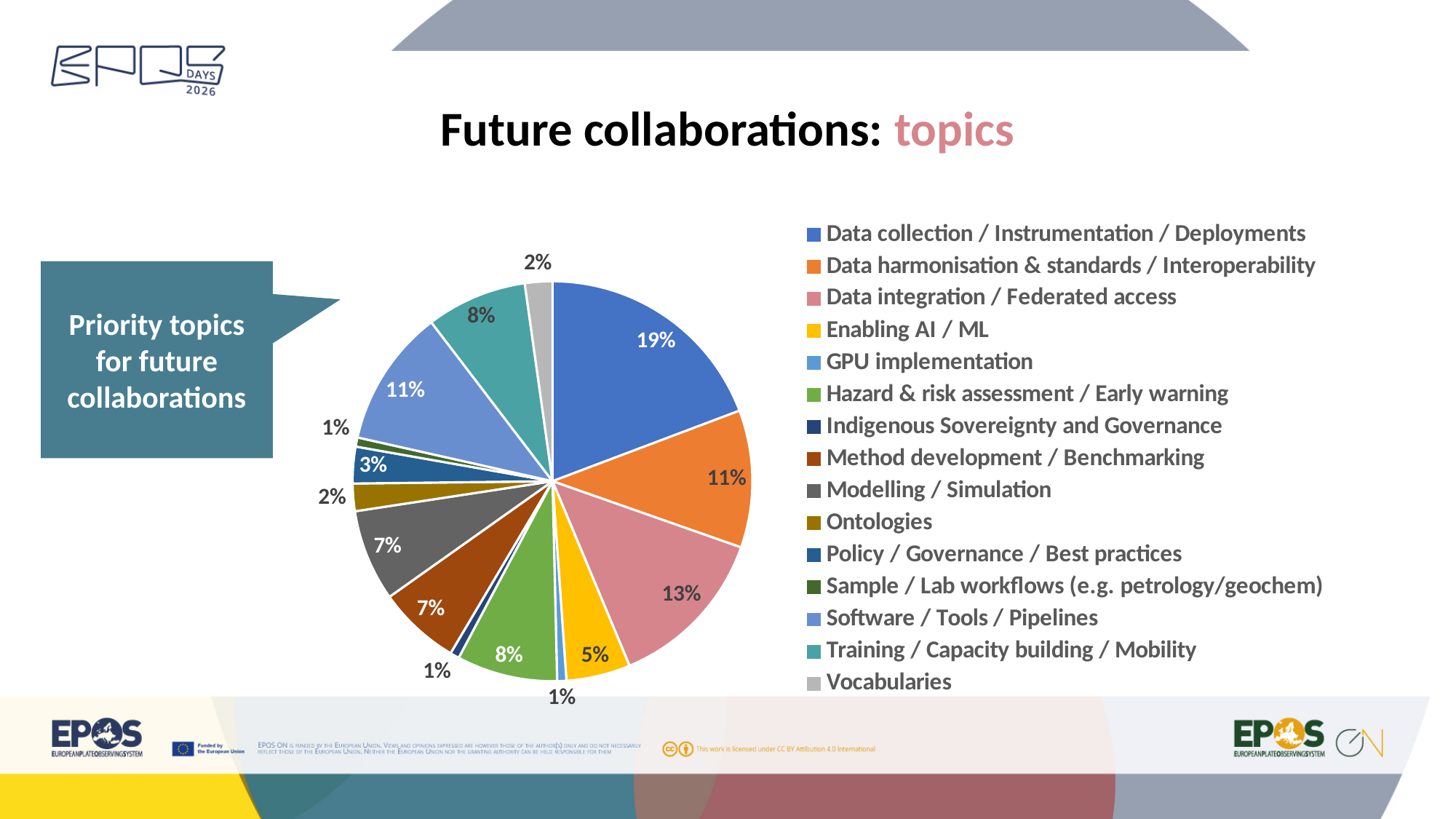
What percentage is shown for Policy / Governance / Best practices? 3% What percentage is shown for Enabling AI / ML? 5% What share of the pie does Data collection / Instrumentation / Deployments have? 19% What is the difference in percentage points between Data collection / Instrumentation / Deployments and Data integration / Federated access? 6 How many topics (slices) does the pie chart show? 15 What type of chart is shown on the slide? pie chart Which topic has the largest share of the pie? Data collection / Instrumentation / Deployments What does the callout box to the left of the pie chart say? Priority topics for future collaborations What percentage is shown for Data integration / Federated access? 13% What percentage is shown for Training / Capacity building / Mobility? 8% What is the title of the slide containing the pie chart? Future collaborations: topics Which has a larger share: Software / Tools / Pipelines or Modelling / Simulation? Software / Tools / Pipelines